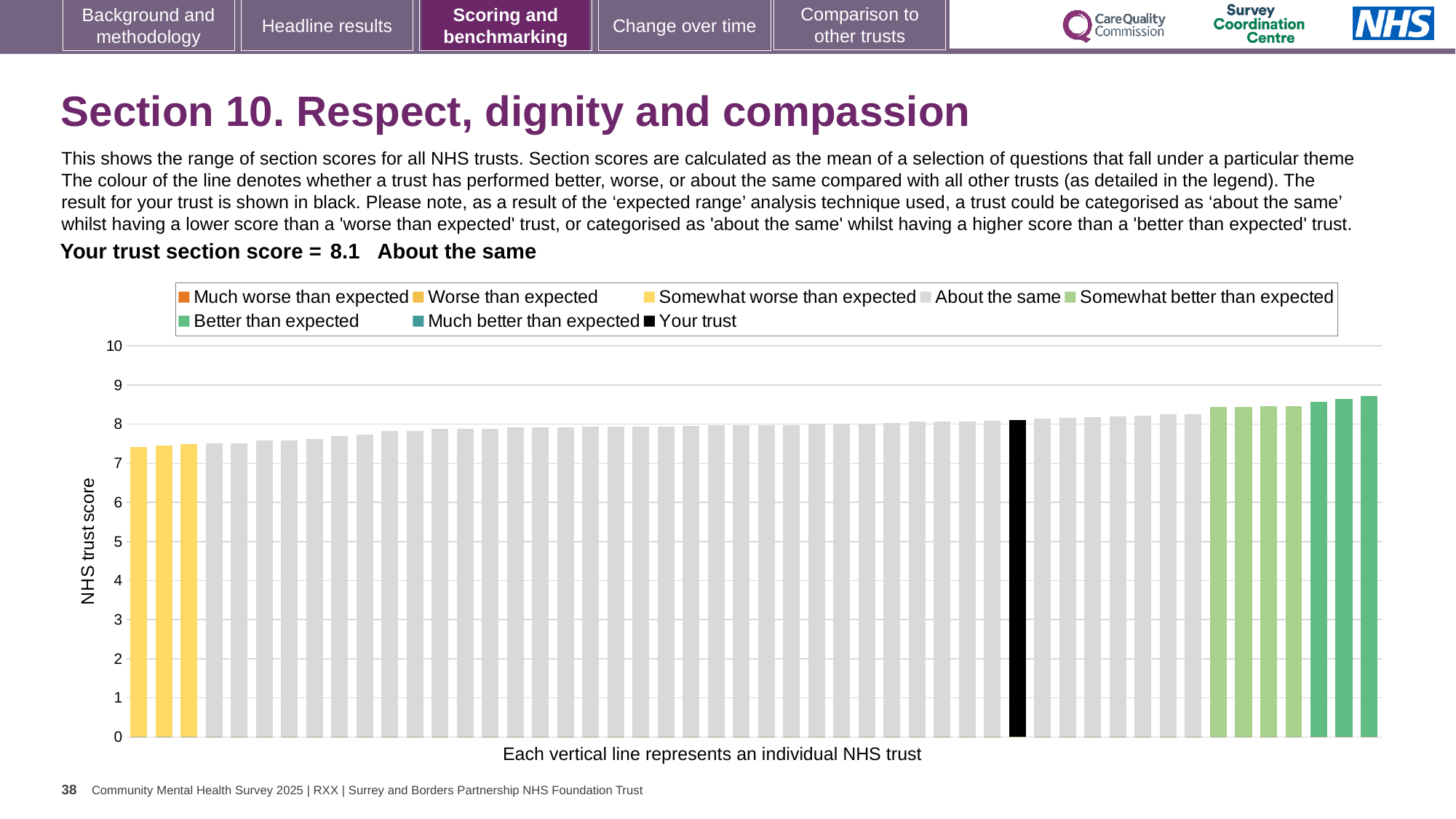
What colour is the bar representing your trust? black Is the value for your trust (the black bar) greater or less than 7? greater What is your trust's section score for Respect, dignity and compassion? 8.1 Is the value of the highest bar greater or less than 9? less What is the label on the vertical axis? NHS trust score What kind of chart is shown on the slide? bar chart Do the trust scores rise or fall from left to right along the x axis? rise Is the value of the lowest bar greater or less than 7? greater Which category does your trust's section score fall into? About the same How many entries does the chart legend list? 8